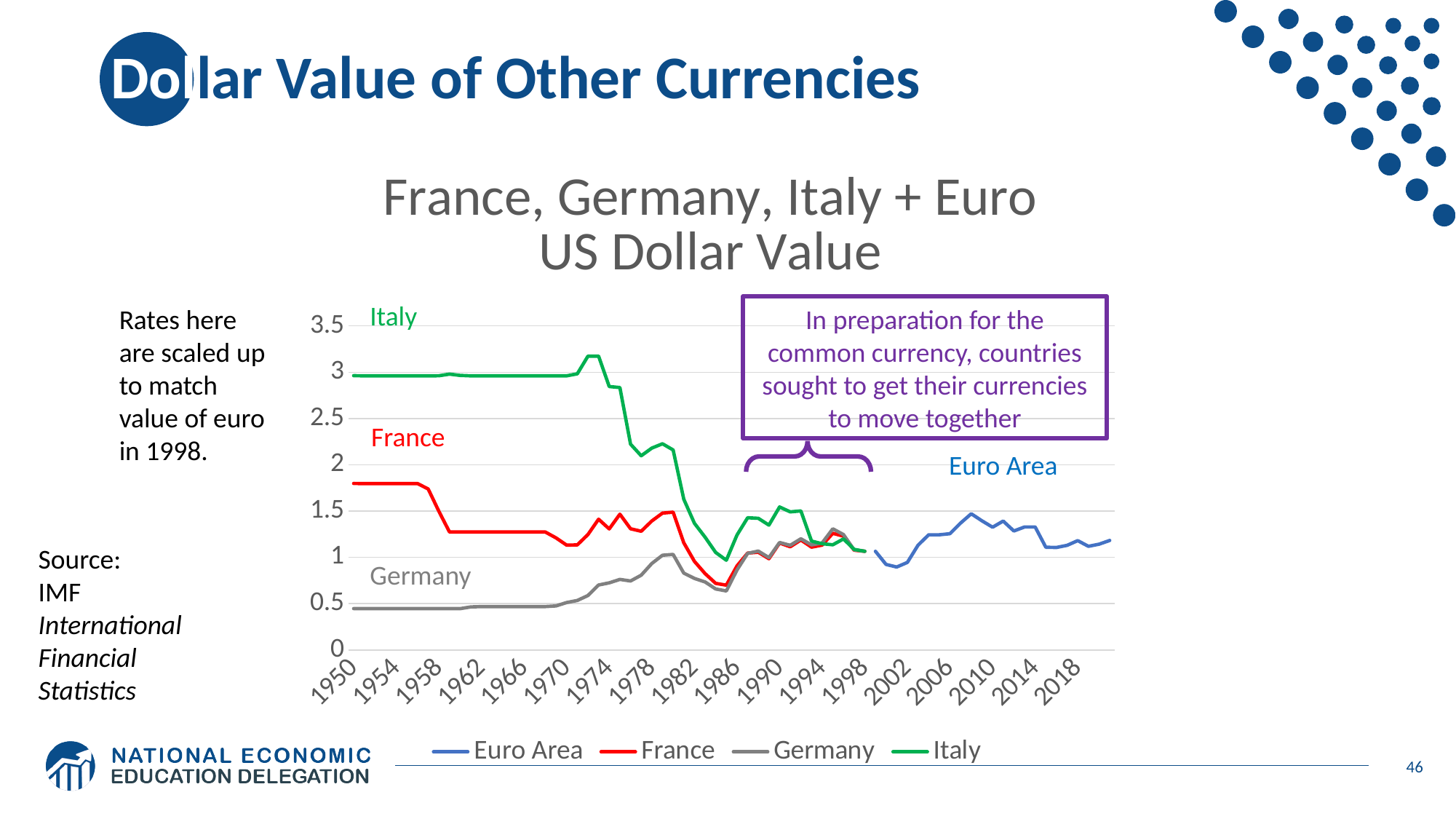
Is the value for the Euro Area in 2002 greater or less than 1? less Which series has the lowest value in 1950? Germany Which series is the only one plotted after 1998? Euro Area Is the value for Italy in 1950 greater or less than 2.5? greater Does the Italy line generally rise or fall between 1950 and 1998? fall How many series does the chart legend list? 4 Is the value for Germany in 1950 greater or less than 1? less Which series has the highest value in 1950? Italy Which is larger in 1962, the value for France or the value for Germany? France What kind of chart is shown on the slide? line chart What colour is the Italy line in the chart? green